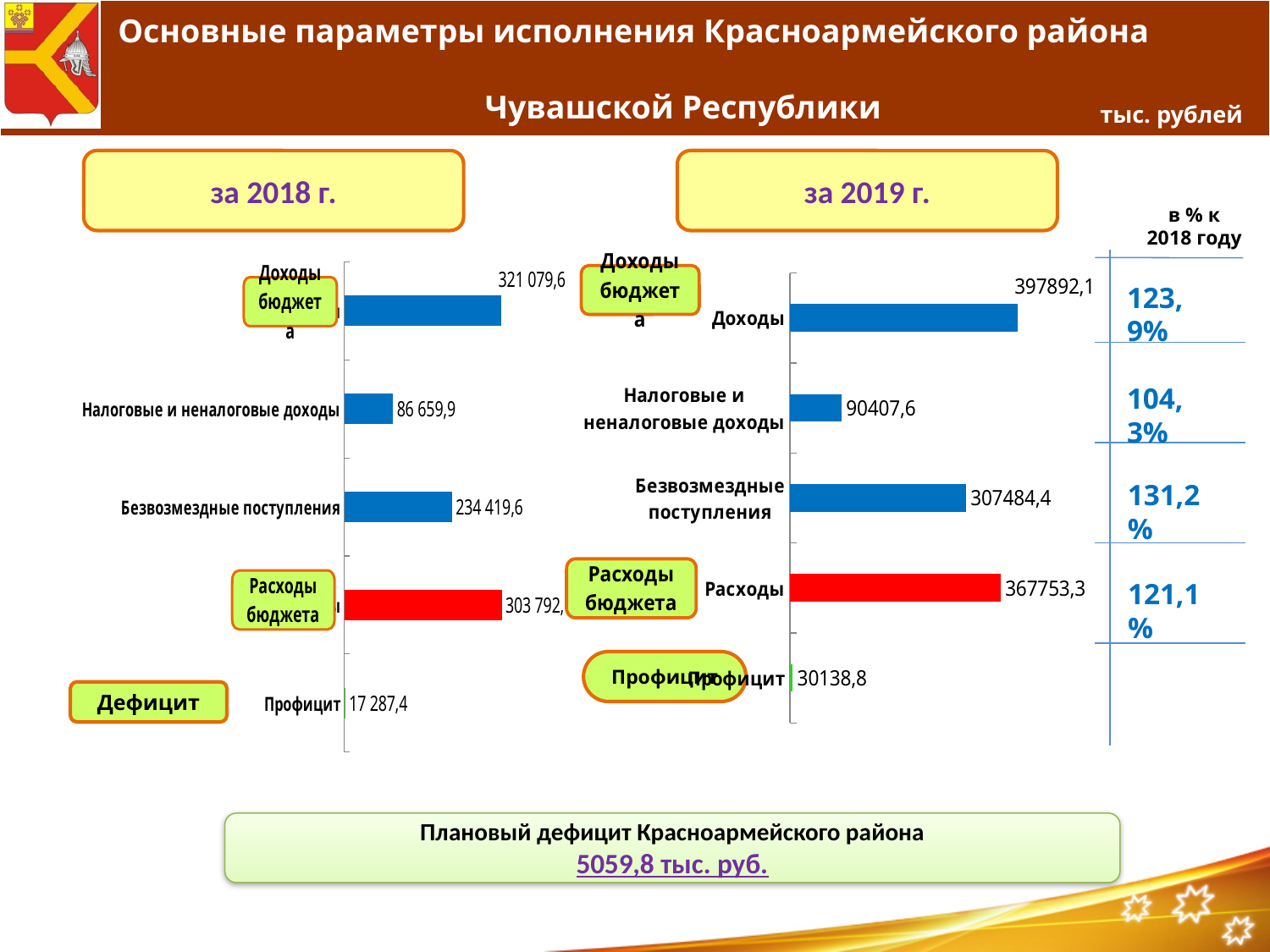
In the chart for 2019 (за 2019 г.), what is the value for Доходы? 397892,1 In the chart for 2019 (за 2019 г.), what is the value for Налоговые и неналоговые доходы? 90407,6 In the chart for 2019 (за 2019 г.), what is the value for Безвозмездные поступления? 307484,4 In the chart for 2018 (за 2018 г.), what is the value for Профицит? 17 287,4 In the chart for 2018 (за 2018 г.), what is the value for Налоговые и неналоговые доходы? 86 659,9 What kind of chart is used for the 2018 (за 2018 г.) data? Bar chart In the chart for 2019 (за 2019 г.), what is the value for Профицит? 30138,8 In the chart for 2019 (за 2019 г.), which category has the lowest value? Профицит In the chart for 2019 (за 2019 г.), which is larger: Безвозмездные поступления or Налоговые и неналоговые доходы? Безвозмездные поступления In the chart for 2019 (за 2019 г.), what is the value for Расходы? 367753,3 In the chart for 2018 (за 2018 г.), what is the value for Безвозмездные поступления? 234 419,6 In the chart for 2019 (за 2019 г.), which category has the highest value? Доходы